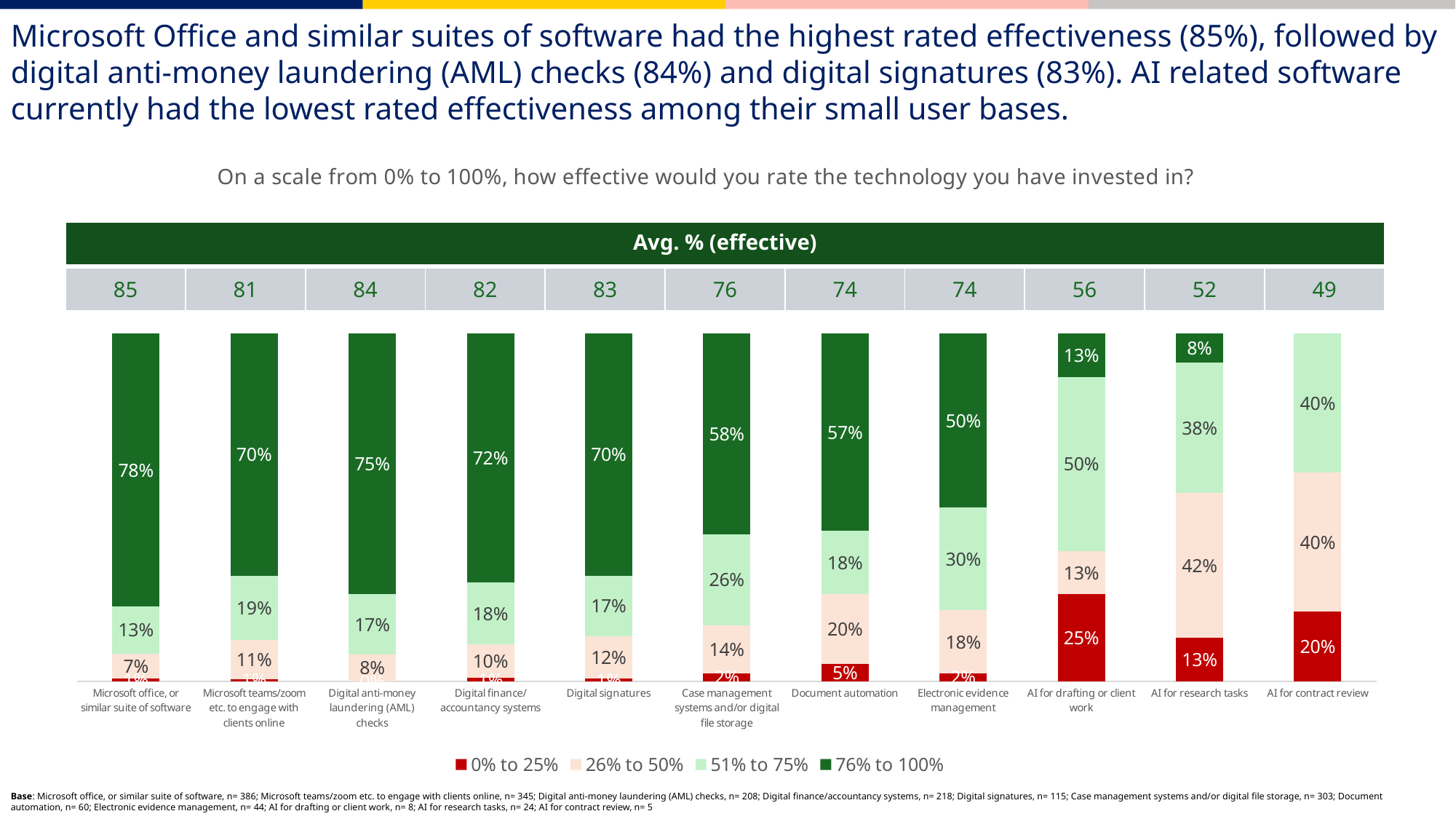
Which technology has the lowest average % effective? AI for contract review What is the average % effective shown for Digital signatures? 83 Which legend entry is shown in dark green? 76% to 100% Which has a larger 51% to 75% value: Electronic evidence management or Case management systems and/or digital file storage? Electronic evidence management How many percentage points higher is the 76% to 100% value for Microsoft office, or similar suite of software than for Digital signatures? 8 How many series does the legend list? 4 What kind of chart is shown on the slide? Stacked bar chart How many technology categories are shown on the x axis? 11 What percentage of AI for drafting or client work users rated effectiveness in the 0% to 25% band? 25% What is the 26% to 50% value for AI for research tasks? 42% Which technology has the largest 76% to 100% segment? Microsoft office, or similar suite of software What percentage of Document automation users rated effectiveness in the 76% to 100% band? 57%